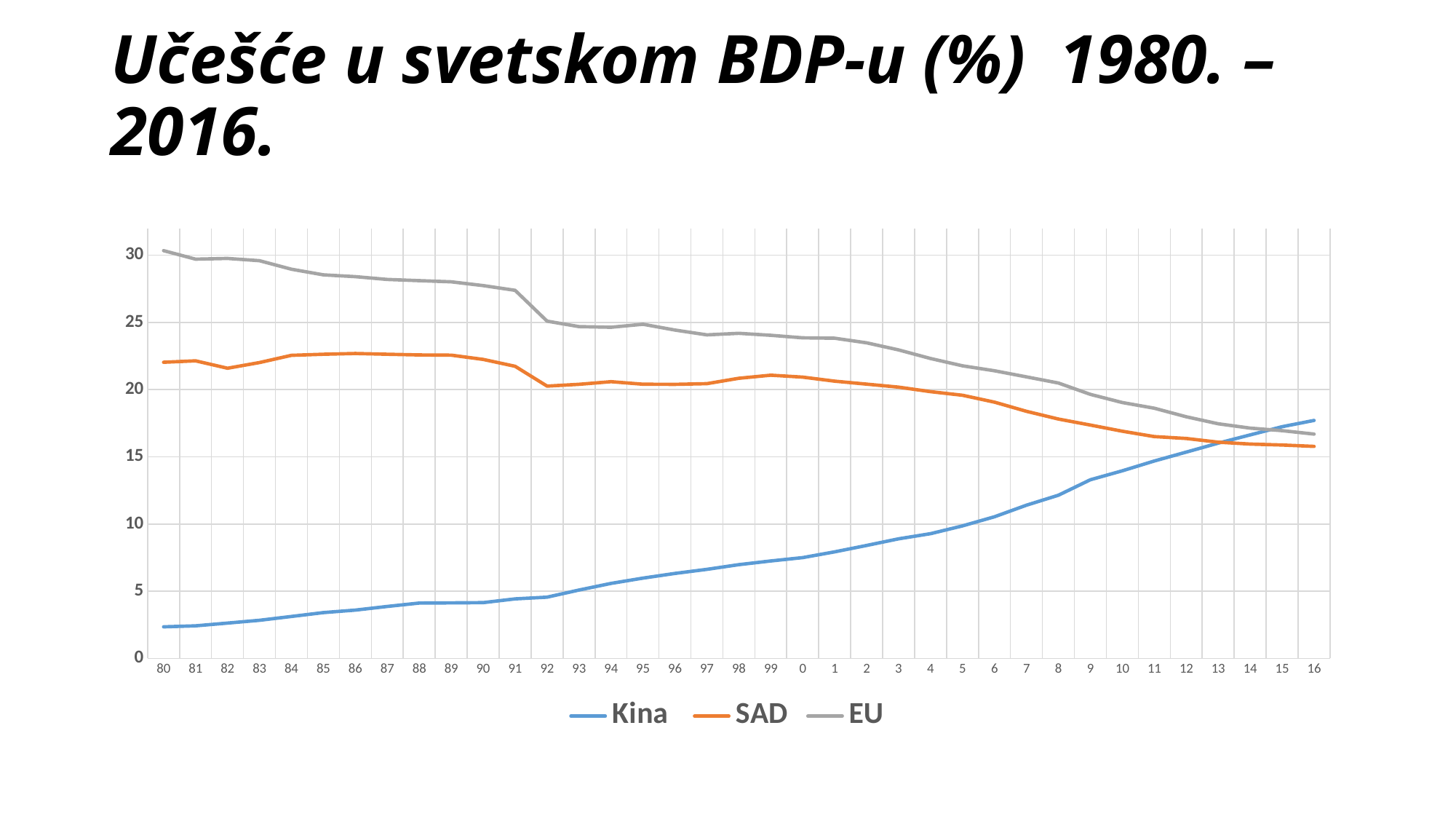
How many series does the legend list? 3 Is the value for Kina at 80 greater or less than 5? less Which series has the highest value at 80? EU Does the Kina line rise or fall from 80 to 16? rises Which series has the lowest value at 80? Kina What kind of chart is shown on the slide? line chart Is the value for EU at 16 greater or less than 20? less Which series are listed in the legend? Kina, SAD, EU How many years (points) are plotted along the x axis? 37 What is the title of the slide? Učešće u svetskom BDP-u (%) 1980. – 2016. Which series has the lowest value at 16? SAD Does the EU line rise or fall from 80 to 16? falls